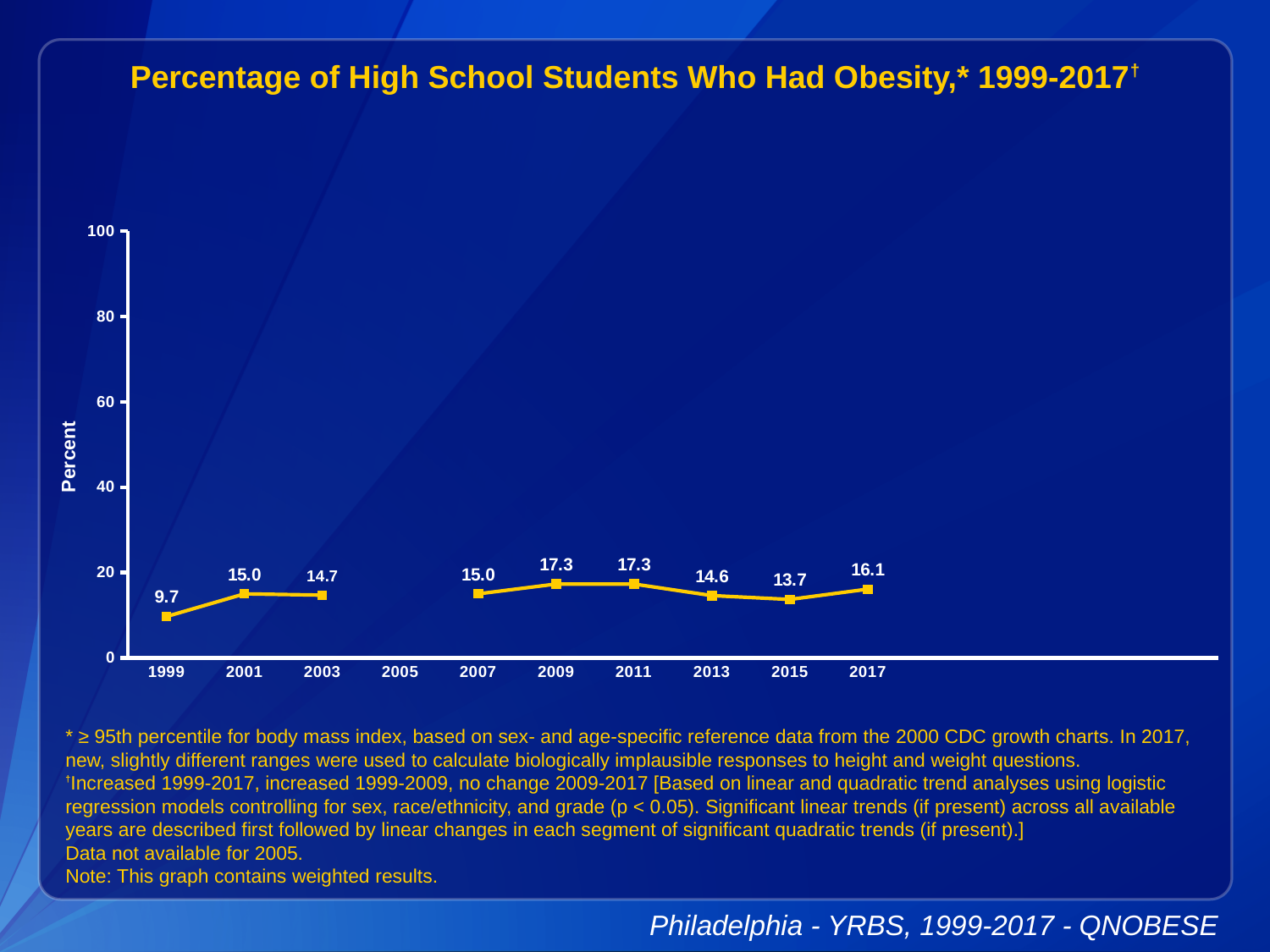
Is the value for 2011 greater or less than 20? less How many years have a data point plotted on the chart? 9 Which years share the highest plotted value? 2009 and 2011 Which year has the larger value, 2001 or 2013? 2001 Which year has the lowest plotted value? 1999 What is the value plotted for 2017? 16.1 What is the difference between the values for 2009 and 2015? 3.6 What kind of chart is shown on the slide? line chart What is the label on the vertical axis? Percent What percentage of high school students had obesity in 1999? 9.7 What is the value plotted for 2015? 13.7 What is the difference between the values for 2017 and 1999? 6.4